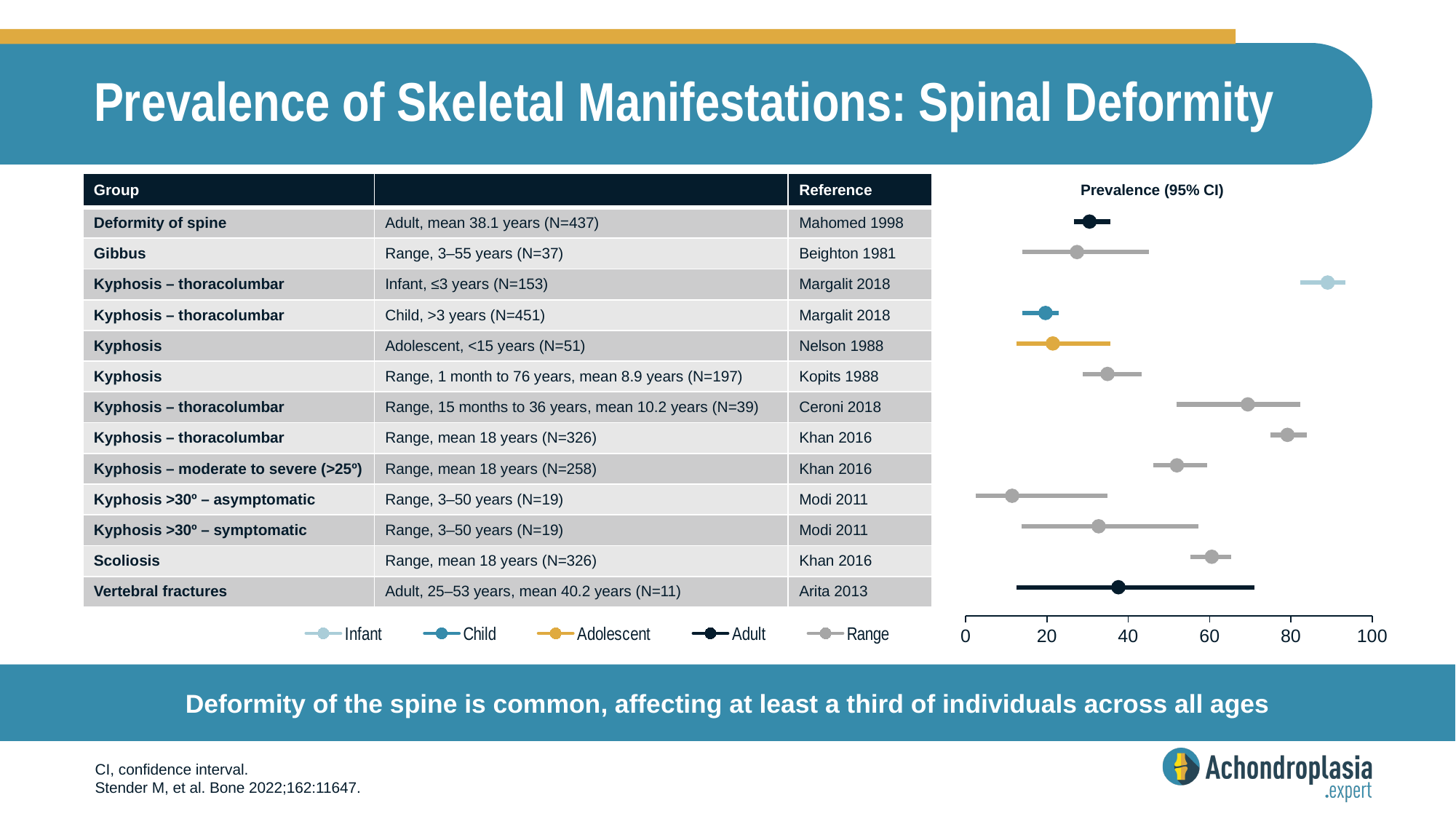
How many series does the legend list? 5 What kind of chart is shown on the right of the slide? forest plot (dot plot with confidence interval bars) What is the title shown above the chart? Prevalence (95% CI) Is the prevalence point estimate for Kyphosis – thoracolumbar, Infant ≤3 years (Margalit 2018) greater or less than 80? greater Which has the larger prevalence point estimate: Kyphosis – thoracolumbar (Ceroni 2018) or Kyphosis (Kopits 1988)? Kyphosis – thoracolumbar (Ceroni 2018) Is the prevalence point estimate for Deformity of spine (Mahomed 1998) greater or less than 40? less Which row has the lowest prevalence point estimate? Kyphosis >30º – asymptomatic (Modi 2011) Is the prevalence point estimate for Kyphosis >30º – asymptomatic (Modi 2011) greater or less than 20? less Which has the larger prevalence point estimate: Scoliosis (Khan 2016) or Gibbus (Beighton 1981)? Scoliosis (Khan 2016) How many study rows (points) are plotted in the Prevalence (95% CI) chart? 13 Which row has the highest prevalence point estimate? Kyphosis – thoracolumbar, Infant, ≤3 years (Margalit 2018)